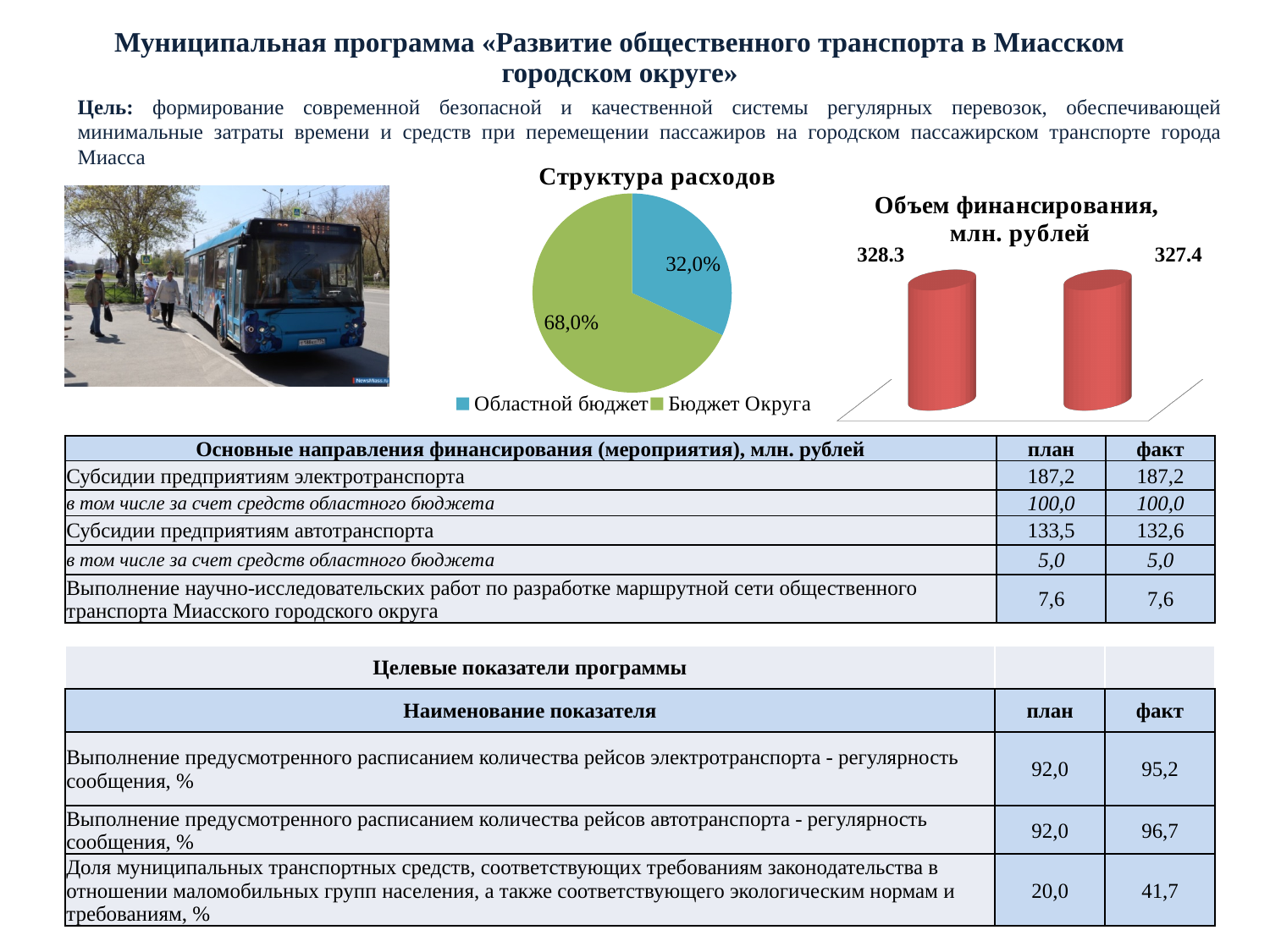
In the chart titled «Объем финансирования, млн. рублей», how many bars are plotted? 2 In the pie chart titled «Структура расходов», which slice is the largest? Бюджет Округа In the pie chart titled «Структура расходов», what share is shown for «Областной бюджет»? 32,0% What kind of chart is the chart titled «Структура расходов»? Pie chart In the pie chart titled «Структура расходов», by how many percentage points does «Бюджет Округа» exceed «Областной бюджет»? 36,0 In the chart titled «Объем финансирования, млн. рублей», what is the value of the right bar? 327.4 In the pie chart titled «Структура расходов», what colour is the «Областной бюджет» slice? Blue In the pie chart titled «Структура расходов», which slice is the smallest? Областной бюджет In the pie chart titled «Структура расходов», how many entries does the legend list? 2 What kind of chart is the chart titled «Объем финансирования, млн. рублей»? Bar chart In the pie chart titled «Структура расходов», what share is shown for «Бюджет Округа»? 68,0% In the chart titled «Объем финансирования, млн. рублей», what is the value of the left bar? 328.3